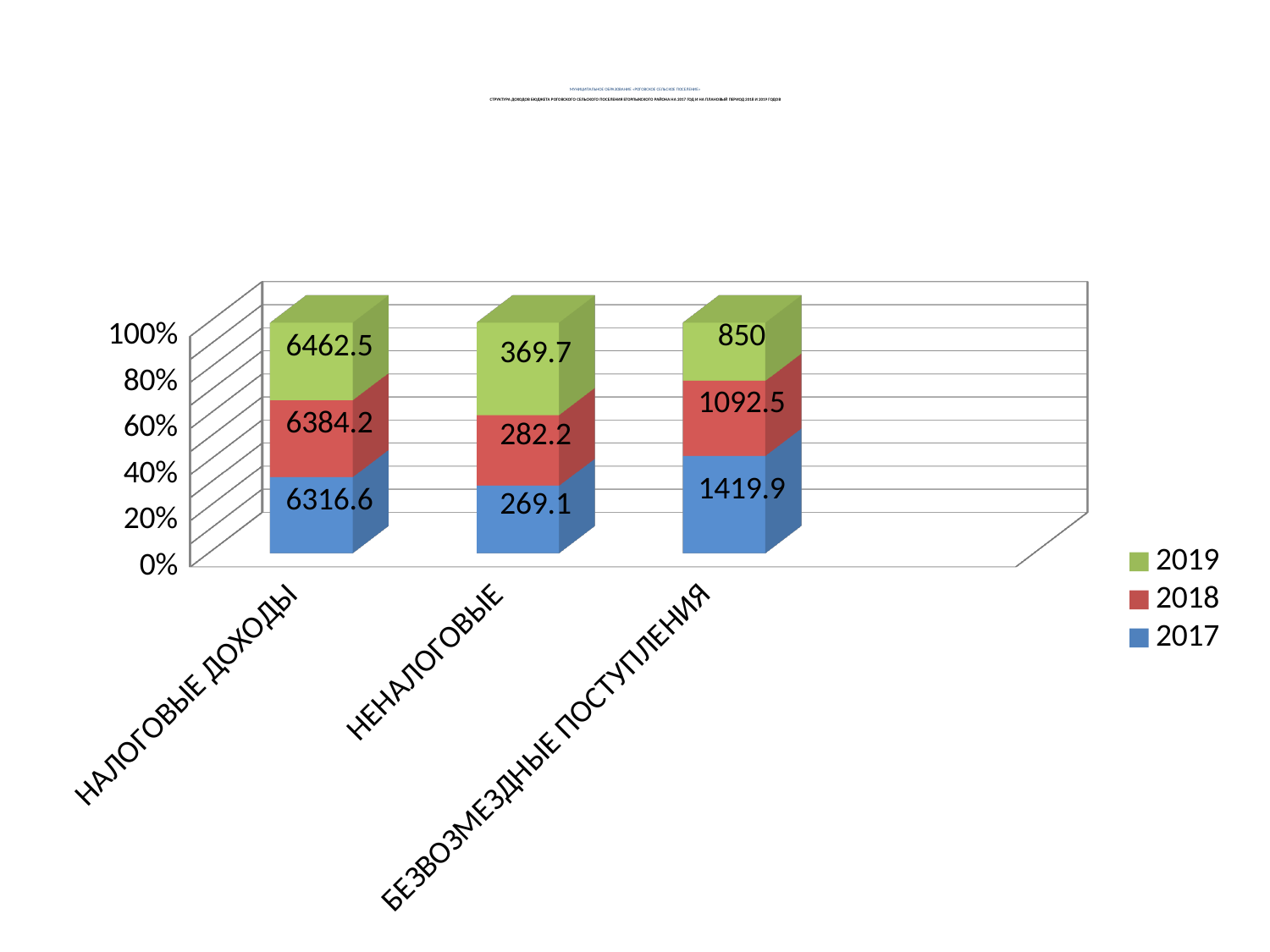
What is the value for 2018 in the НЕНАЛОГОВЫЕ category? 282.2 How many categories are shown on the x axis? 3 What is the difference between the 2019 and 2017 values for НАЛОГОВЫЕ ДОХОДЫ? 145.9 Which category has the highest value for 2017? НАЛОГОВЫЕ ДОХОДЫ What is the value for 2019 in the НАЛОГОВЫЕ ДОХОДЫ category? 6462.5 What is the value for 2019 in the БЕЗВОЗМЕЗДНЫЕ ПОСТУПЛЕНИЯ category? 850 Which category has the lowest value for 2019? НЕНАЛОГОВЫЕ What is the value for 2017 in the БЕЗВОЗМЕЗДНЫЕ ПОСТУПЛЕНИЯ category? 1419.9 Which colour represents the 2018 series in the legend? Red How many series does the legend list? 3 What kind of chart is shown on the slide? Stacked bar chart Which is larger for БЕЗВОЗМЕЗДНЫЕ ПОСТУПЛЕНИЯ: the 2017 value or the 2019 value? 2017